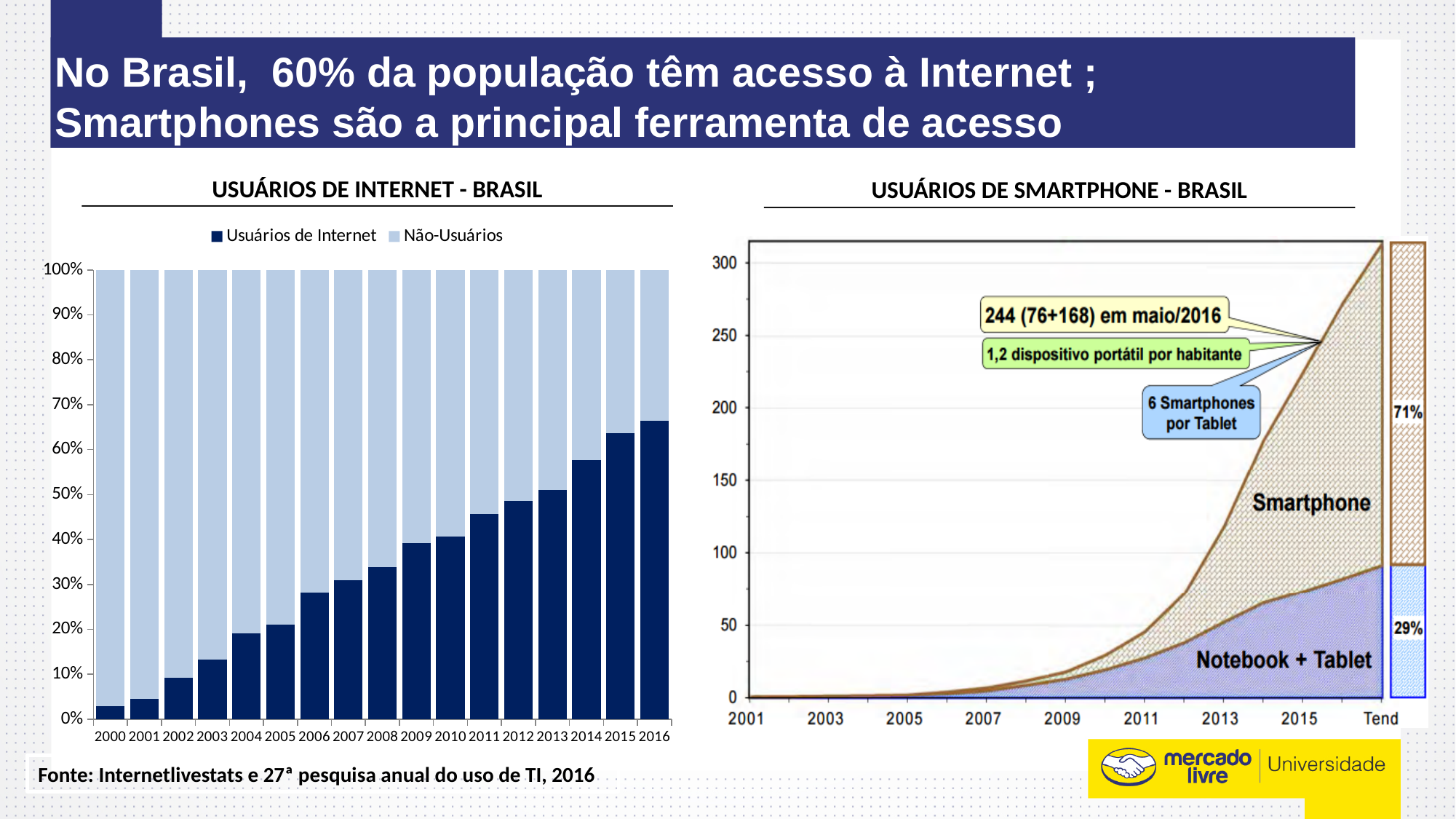
What kind of chart is the 'USUÁRIOS DE INTERNET - BRASIL' chart on the left? Stacked bar chart How many series does the legend of the 'USUÁRIOS DE INTERNET - BRASIL' chart list? 2 In the 'USUÁRIOS DE INTERNET - BRASIL' chart, is the Usuários de Internet value for 2016 greater or less than 60%? greater In the 'USUÁRIOS DE INTERNET - BRASIL' chart, is the Usuários de Internet value for 2014 greater or less than 50%? greater In the 'USUÁRIOS DE SMARTPHONE - BRASIL' chart, what percentage is shown for Notebook + Tablet in the bar on the right? 29% In the 'USUÁRIOS DE INTERNET - BRASIL' chart, which year has the lowest share of Usuários de Internet? 2000 In the 'USUÁRIOS DE SMARTPHONE - BRASIL' chart, what total number of devices is annotated for maio/2016? 244 How many years are shown on the x axis of the 'USUÁRIOS DE INTERNET - BRASIL' chart? 17 In the 'USUÁRIOS DE INTERNET - BRASIL' chart, which year has the highest share of Usuários de Internet? 2016 In the 'USUÁRIOS DE INTERNET - BRASIL' chart, does the share of Usuários de Internet rise or fall from 2000 to 2016? Rise In the 'USUÁRIOS DE INTERNET - BRASIL' chart, is the Usuários de Internet value for 2000 greater or less than 10%? less In the 'USUÁRIOS DE SMARTPHONE - BRASIL' chart, what percentage is shown for Smartphone in the bar on the right? 71%